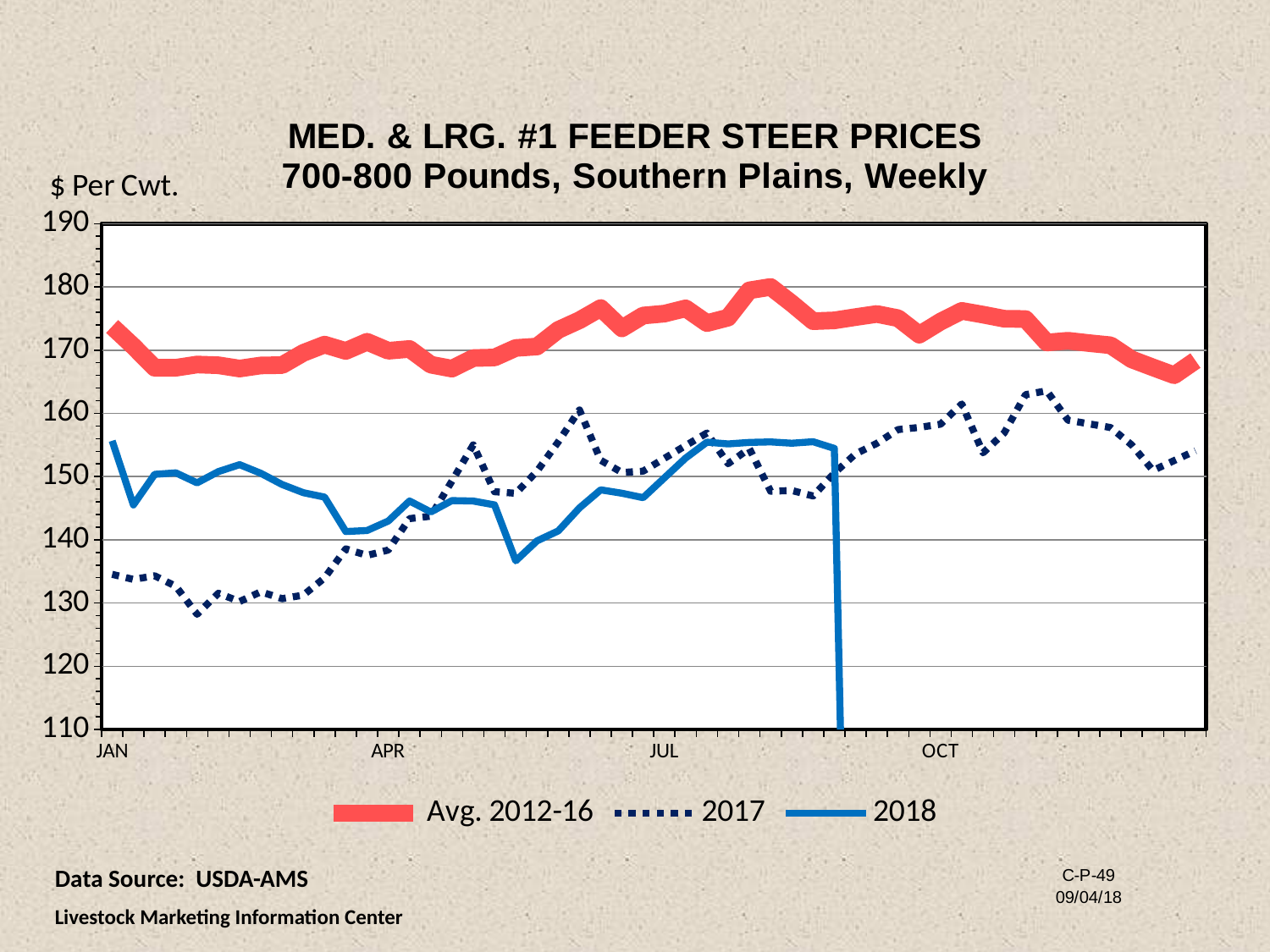
Which series has the highest values across the whole chart? Avg. 2012-16 Does the 2017 series generally rise or fall from JAN to OCT? rise At OCT, which series has the higher value, Avg. 2012-16 or 2017? Avg. 2012-16 What is the label on the vertical axis of the chart? $ Per Cwt. How many series does the legend list? 3 What kind of chart is shown on the slide? line chart Which series is drawn as a dotted line in the chart? 2017 Is the value for 2018 at JAN greater or less than 150? greater Is the value for 2017 at JAN greater or less than 140? less Is the value for 2017 at OCT greater or less than 150? greater At JAN, which series has the higher value, 2017 or 2018? 2018